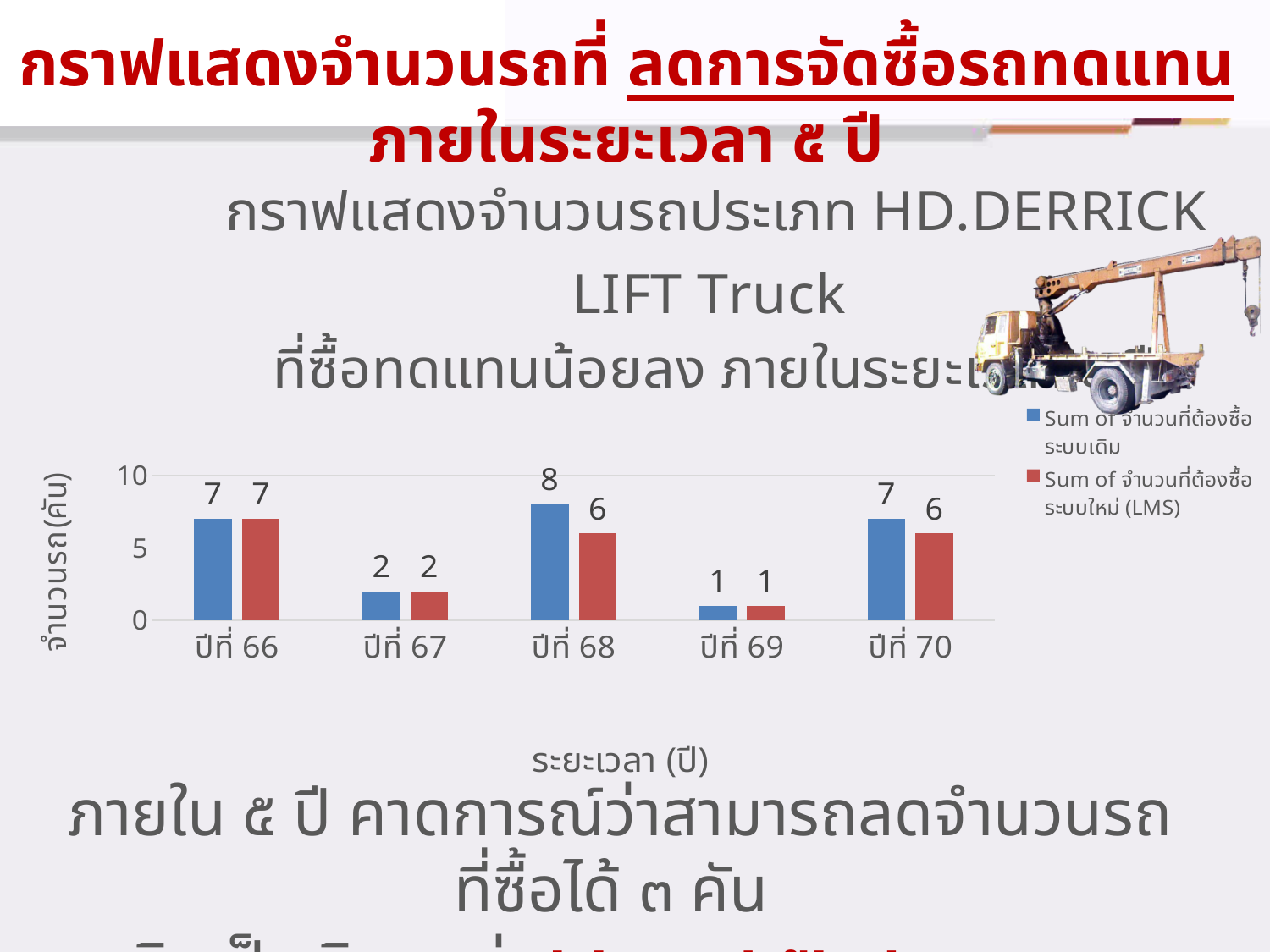
How many series does the chart legend list? 2 For ปีที่ 70, which is larger: Sum of จำนวนที่ต้องซื้อ ระบบเดิม or Sum of จำนวนที่ต้องซื้อ ระบบใหม่ (LMS)? Sum of จำนวนที่ต้องซื้อ ระบบเดิม What is the difference between Sum of จำนวนที่ต้องซื้อ ระบบเดิม and Sum of จำนวนที่ต้องซื้อ ระบบใหม่ (LMS) for ปีที่ 68? 2 Which year has the highest value for Sum of จำนวนที่ต้องซื้อ ระบบเดิม? ปีที่ 68 What is the label of the y axis of the chart? จำนวนรถ(คัน) What is the value of Sum of จำนวนที่ต้องซื้อ ระบบเดิม for ปีที่ 68? 8 Is the value of Sum of จำนวนที่ต้องซื้อ ระบบเดิม for ปีที่ 67 greater or less than 5? less What is the value of Sum of จำนวนที่ต้องซื้อ ระบบเดิม for ปีที่ 69? 1 What type of chart is shown on the slide? bar chart What is the value of Sum of จำนวนที่ต้องซื้อ ระบบใหม่ (LMS) for ปีที่ 70? 6 Which year has the lowest value for Sum of จำนวนที่ต้องซื้อ ระบบใหม่ (LMS)? ปีที่ 69 How many year categories are shown on the x axis of the chart? 5